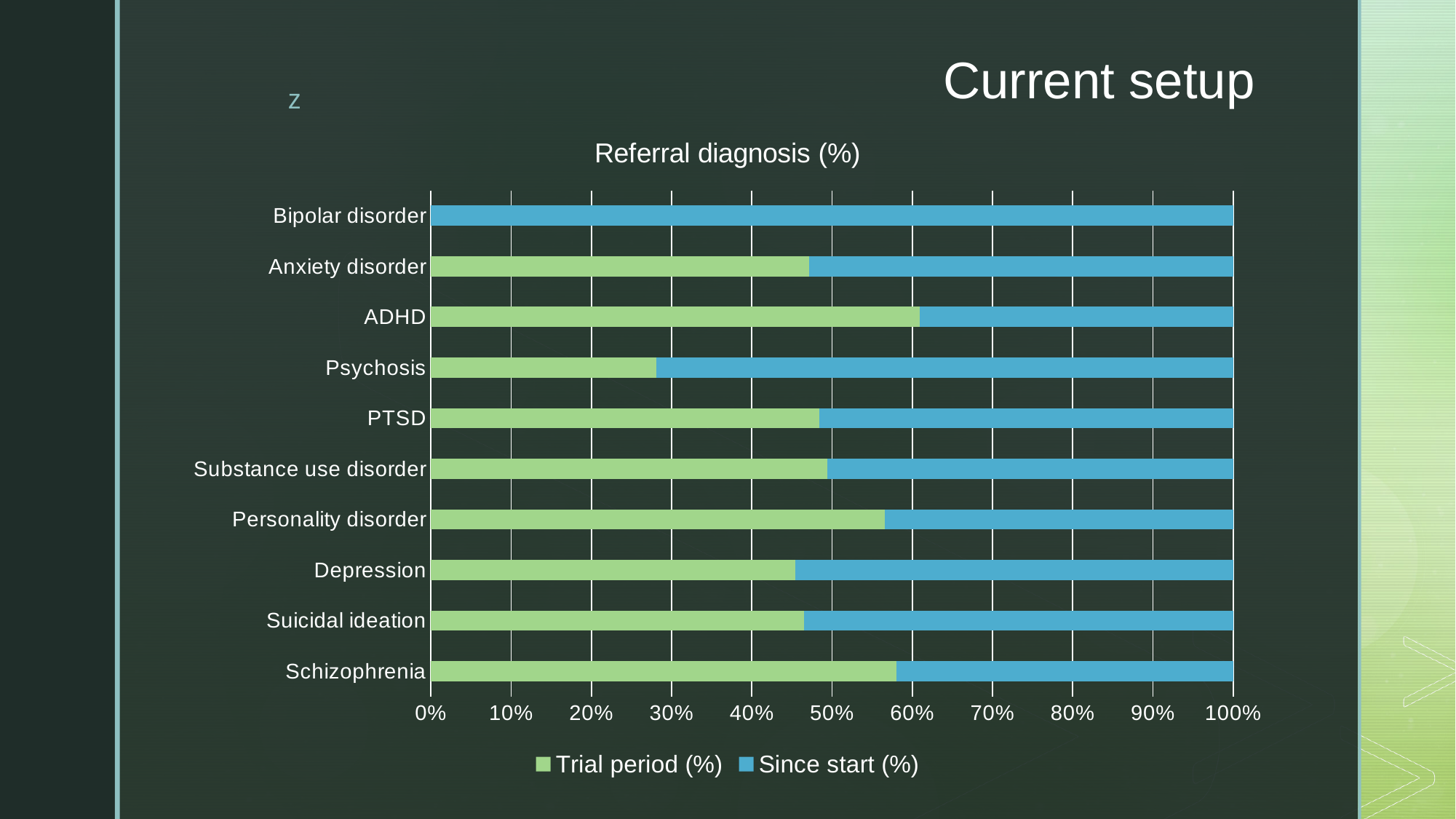
Is the Trial period (%) value for Depression greater or less than 50%? less Is the Trial period (%) value for Psychosis greater or less than 30%? less Which has the larger Trial period (%) segment, Psychosis or ADHD? ADHD Is the Trial period (%) value for Schizophrenia greater or less than 50%? greater Which colour represents the Since start (%) series? blue How many series does the legend list? 2 What is the total of the stacked bar for Psychosis? 100% Which category has no Trial period (%) segment at all? Bipolar disorder Which category has the largest Trial period (%) segment? ADHD How many diagnosis categories are plotted on the chart? 10 What is the title of the chart? Referral diagnosis (%) What kind of chart is shown on the slide? bar chart